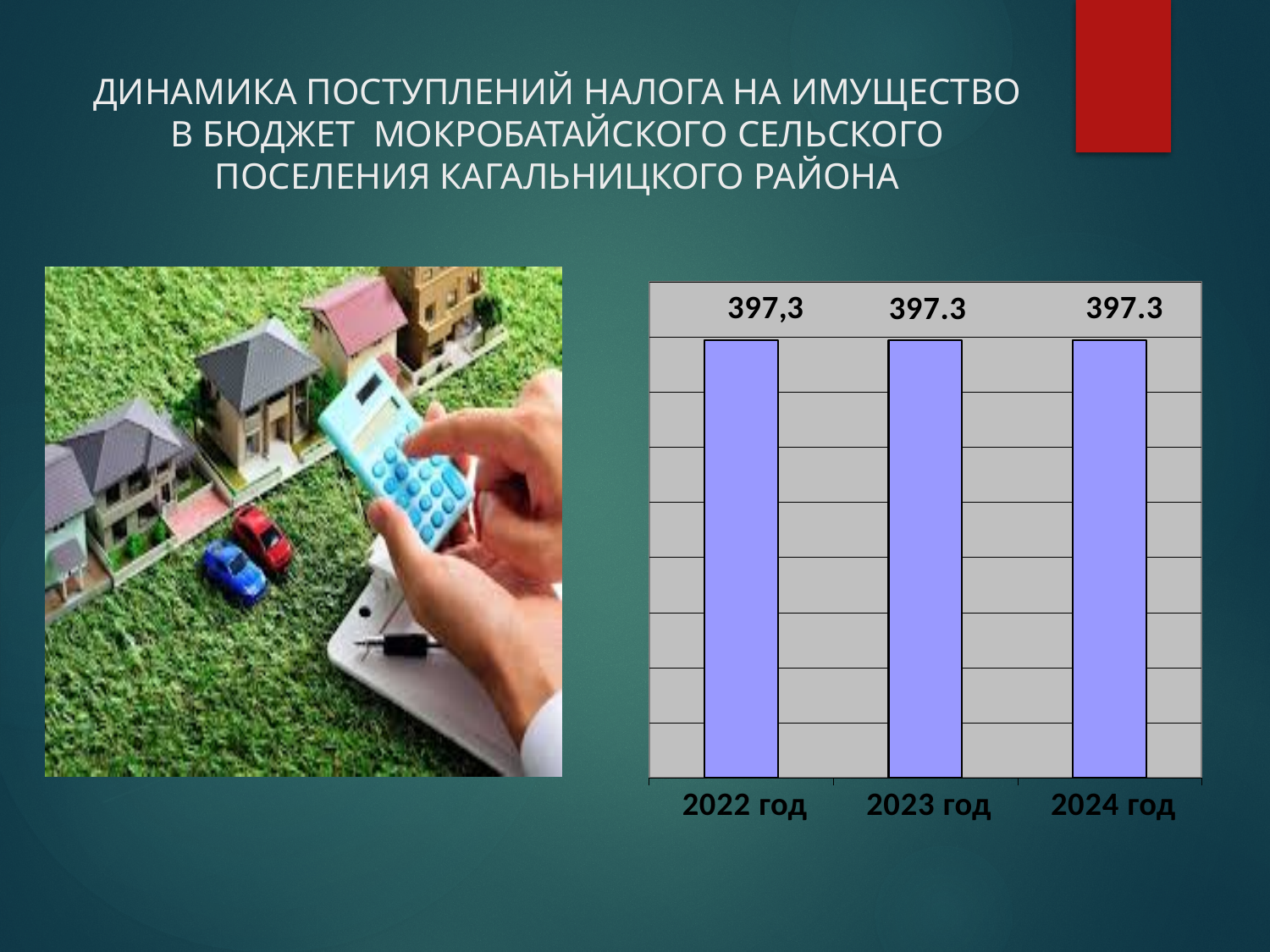
Is the value for 2022 год larger than, smaller than, or equal to the value for 2024 год? equal What is the difference between the values for 2023 год and 2024 год? 0 What is the value shown for 2024 год? 397.3 How many years (categories) are shown on the chart? 3 What colour are the bars in the chart? blue (light purple-blue) What is the value shown for 2023 год? 397.3 What kind of chart is shown on the slide? bar chart Do the values rise, fall or stay the same from 2022 год to 2024 год? stay the same What is the value shown for 2022 год? 397,3 Which year is the first category on the x axis? 2022 год